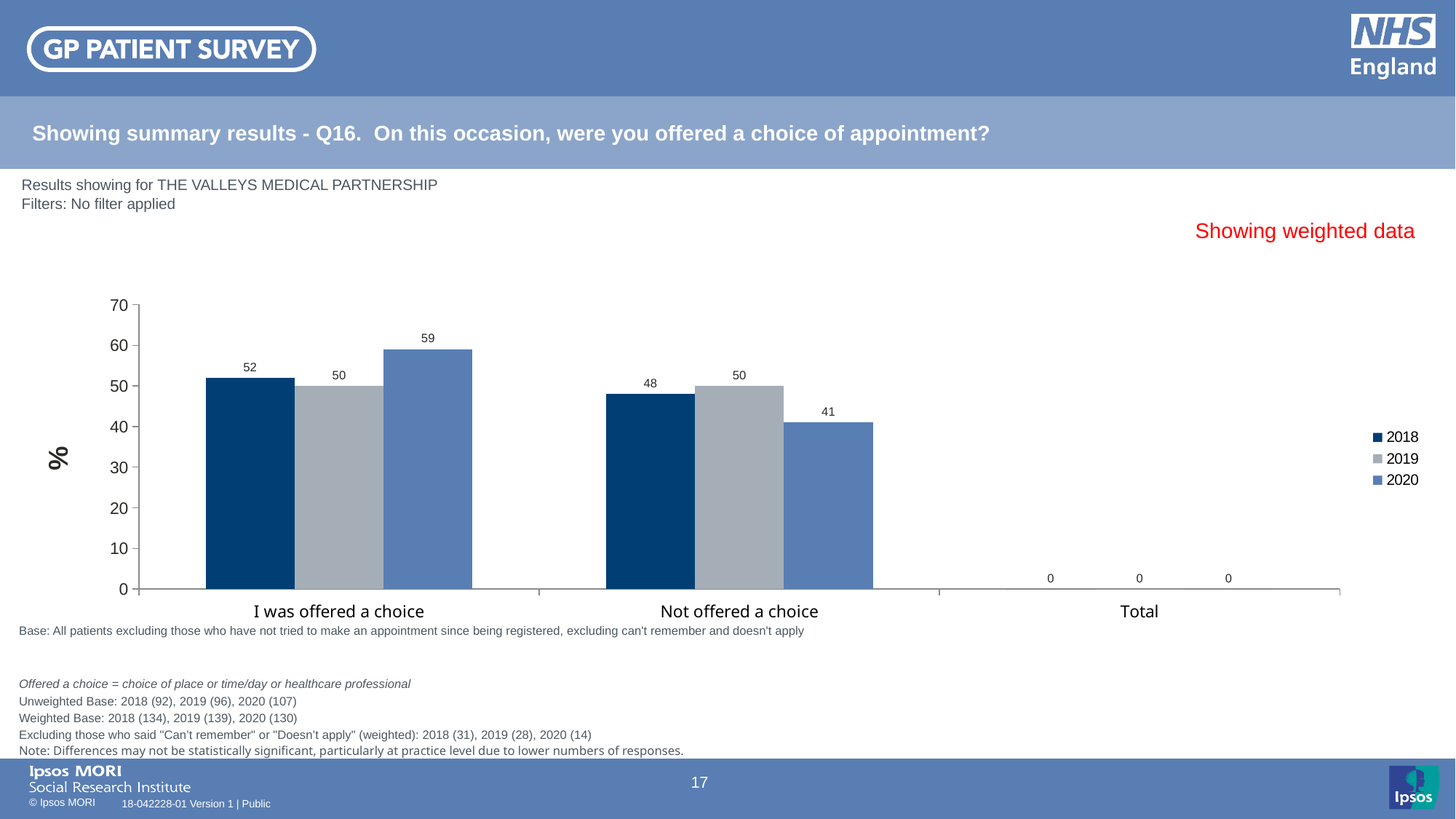
How many series does the legend list? 3 How many categories are shown on the x axis? 3 Which year has the lowest value in the 'Not offered a choice' category? 2020 What is the value for 2019 in the 'I was offered a choice' category? 50 What is the value for 2020 in the 'I was offered a choice' category? 59 Which is larger: the 2018 value for 'I was offered a choice' or the 2018 value for 'Not offered a choice'? I was offered a choice What kind of chart is shown on the slide? Bar chart What label is shown on the y axis? % What is the value for 2018 in the 'Not offered a choice' category? 48 Which year has the highest value in the 'I was offered a choice' category? 2020 What is the difference between the 2020 and 2018 values in the 'I was offered a choice' category? 7 What is the difference between the 2019 and 2020 values in the 'Not offered a choice' category? 9